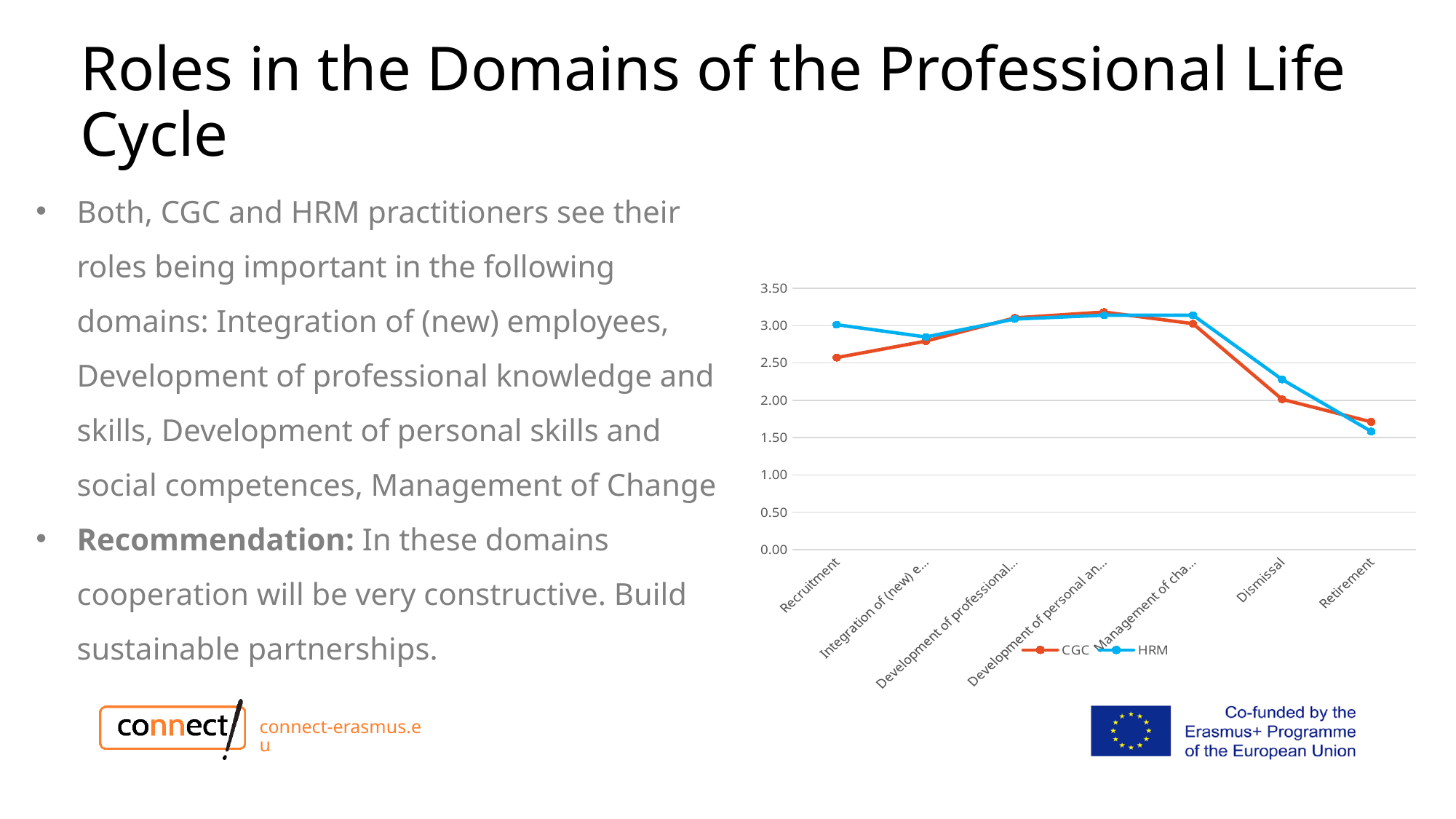
How many categories are plotted along the x axis of the chart? 7 Do the values of both series rise or fall from Dismissal to Retirement? fall What kind of chart is shown on the slide? line chart Which of the two series has the larger value for Dismissal? HRM What are the two series names shown in the chart's legend? CGC and HRM Which series has the lowest value for Recruitment, CGC or HRM? CGC How many series does the chart's legend list? 2 Is the HRM value for Retirement greater or less than 2.00? less For the CGC series, which category has the lowest value? Retirement Is the CGC value for Dismissal greater or less than 2.50? less Is the HRM value for Recruitment greater or less than 2.50? greater